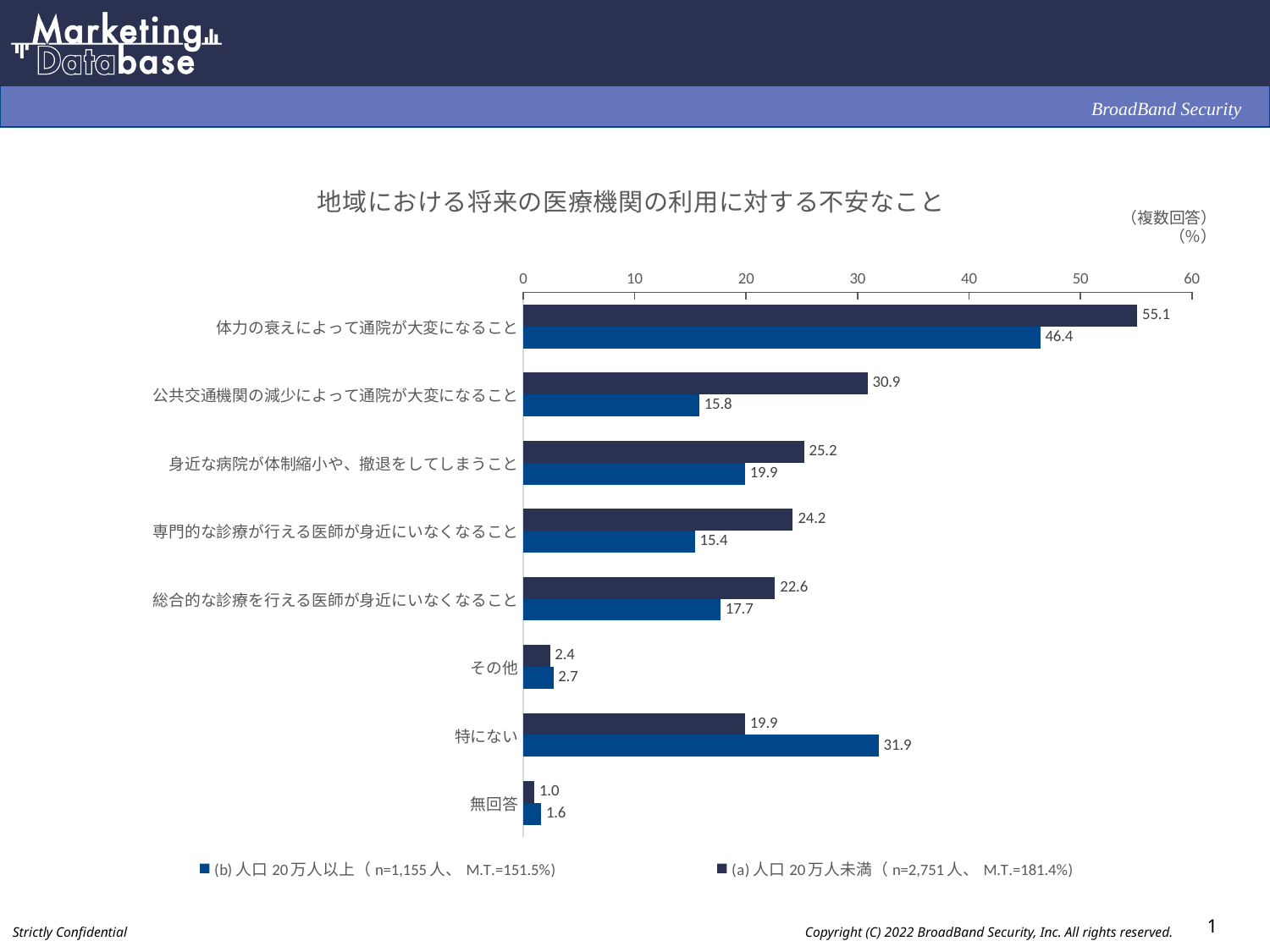
Which category has the lowest value for the (b) 人口20万人以上 series? 無回答 Is the value for 身近な病院が体制縮小や、撤退をしてしまうこと in the (a) 人口20万人未満 series greater or less than 20? greater What is the value for 公共交通機関の減少によって通院が大変になること for the (b) 人口20万人以上 series? 15.8 What is the value for 体力の衰えによって通院が大変になること for the (a) 人口20万人未満 series? 55.1 Which category has the highest value for the (a) 人口20万人未満 series? 体力の衰えによって通院が大変になること What is the value for 特にない for the (b) 人口20万人以上 series? 31.9 How many categories are shown on the chart? 8 What is the difference between the (a) 人口20万人未満 and (b) 人口20万人以上 values for 体力の衰えによって通院が大変になること? 8.7 What kind of chart is shown on the slide? Bar chart What is the difference between the (b) 人口20万人以上 and (a) 人口20万人未満 values for 特にない? 12.0 For 専門的な診療が行える医師が身近にいなくなること, which series has the larger value? (a) 人口20万人未満 How many series does the legend list? 2